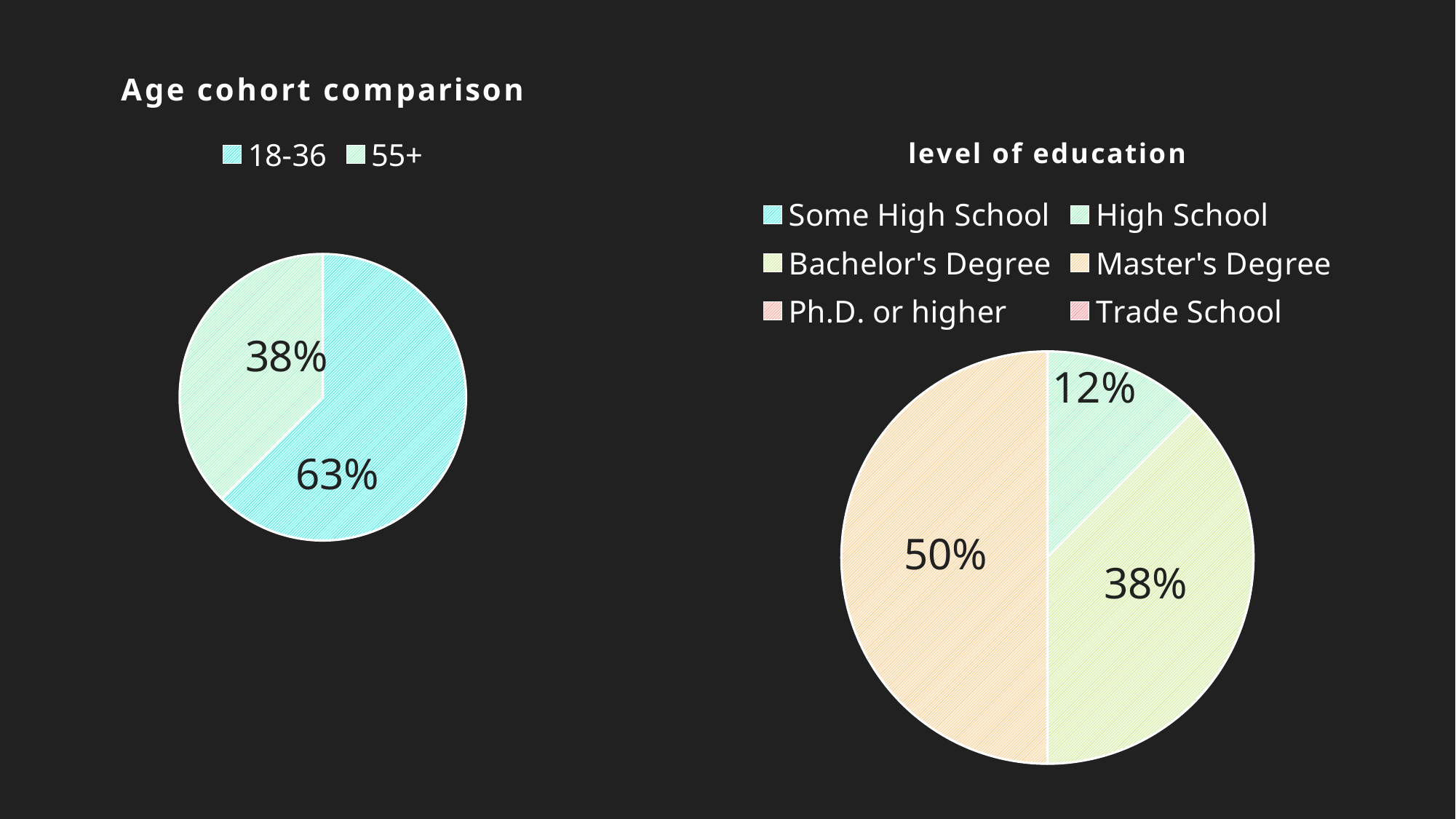
In the 'Age cohort comparison' chart, what is the difference between the 18-36 and 55+ shares? 25% In the 'level of education' chart, which is larger: the Bachelor's Degree slice or the Master's Degree slice? Master's Degree In the 'Age cohort comparison' chart, what share does the 18-36 cohort have? 63% How many slices with data labels are visible in the 'level of education' chart? 3 What kind of chart is the 'Age cohort comparison' chart? pie chart In the 'Age cohort comparison' chart, which cohort has the larger slice? 18-36 How many entries does the legend of the 'Age cohort comparison' chart list? 2 In the 'Age cohort comparison' chart, what share does the 55+ cohort have? 38% In the 'level of education' chart, what share does Bachelor's Degree have? 38% In the 'level of education' chart, what share does Master's Degree have? 50% In the 'level of education' chart, which category has the largest slice? Master's Degree How many entries does the legend of the 'level of education' chart list? 6